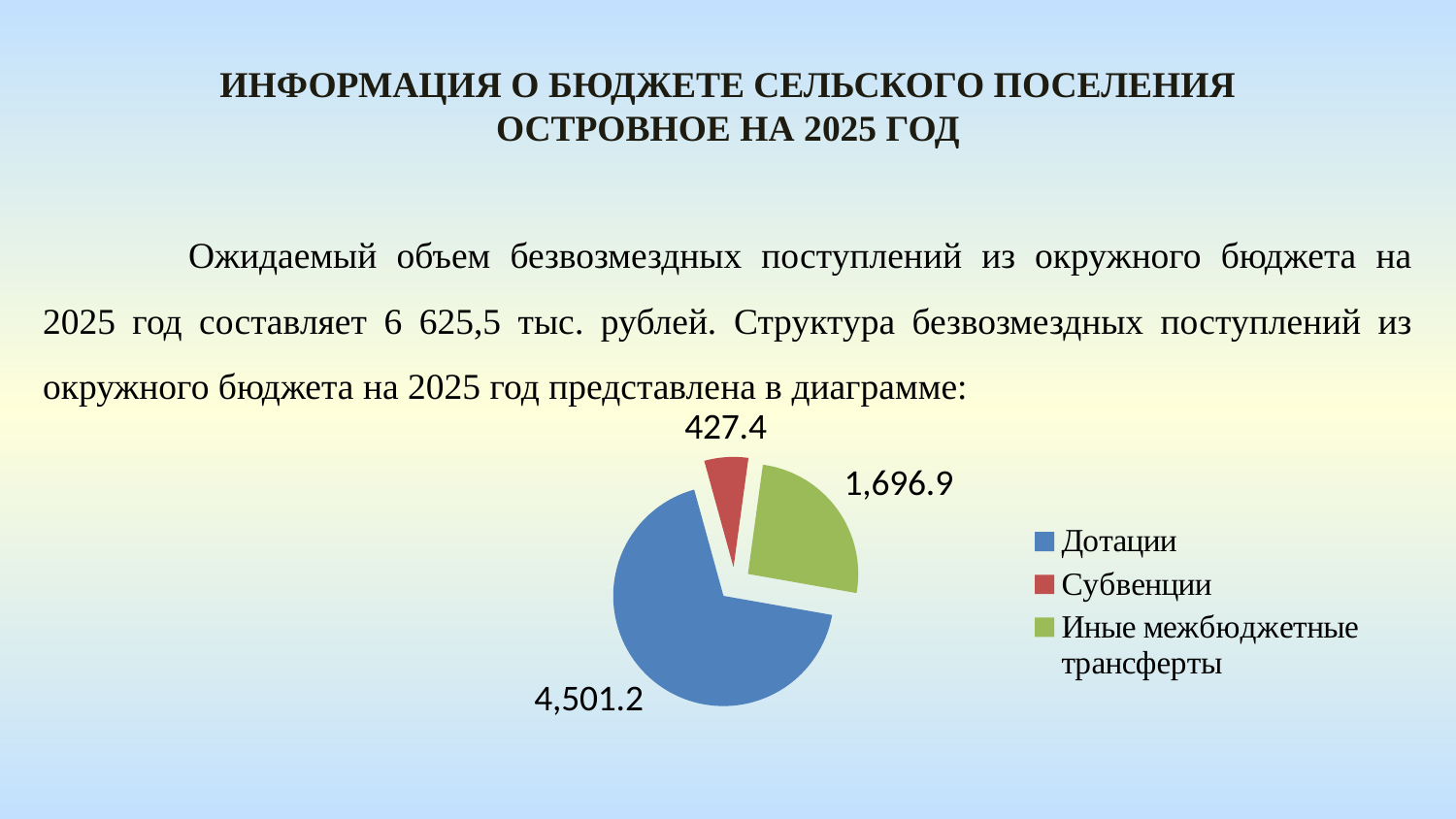
What colour is the slice for Субвенции? red What is the difference between the values for Иные межбюджетные трансферты and Субвенции? 1,269.5 What is the total of all slices in the pie chart? 6,625.5 What is the difference between the values for Дотации and Субвенции? 4,073.8 How many slices does the pie chart have? 3 What is the value for Иные межбюджетные трансферты in the pie chart? 1,696.9 What is the value for Субвенции in the pie chart? 427.4 Which is larger, the value for Иные межбюджетные трансферты or the value for Субвенции? Иные межбюджетные трансферты Which category has the largest slice in the pie chart? Дотации Which category has the smallest slice in the pie chart? Субвенции What is the value for Дотации in the pie chart? 4,501.2 What type of chart is shown on the slide? pie chart